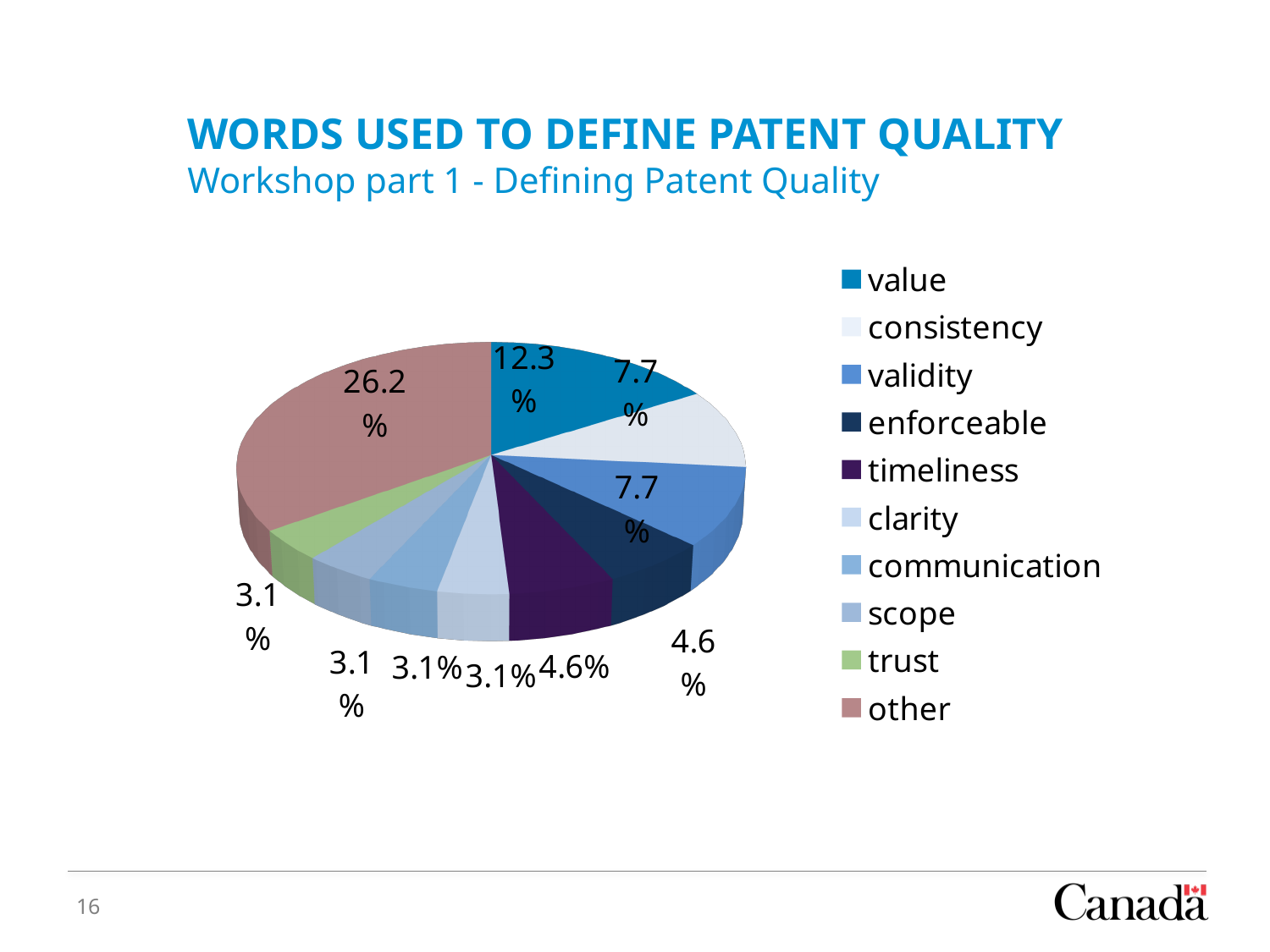
Which category has the highest value in the pie chart? other How many entries does the legend list? 10 What is the value shown for the 'other' slice? 26.2% What kind of chart is shown on the slide? pie chart What is the value shown for the 'trust' slice? 3.1% What is the value shown for the 'value' slice? 12.3% What is the value shown for the 'timeliness' slice? 4.6% Which has a larger value, 'value' or 'validity'? value What is the value shown for the 'consistency' slice? 7.7% What is the title of the slide containing the chart? WORDS USED TO DEFINE PATENT QUALITY How many categories does the pie chart show? 10 What is the difference between the values for 'other' and 'value'? 13.9%